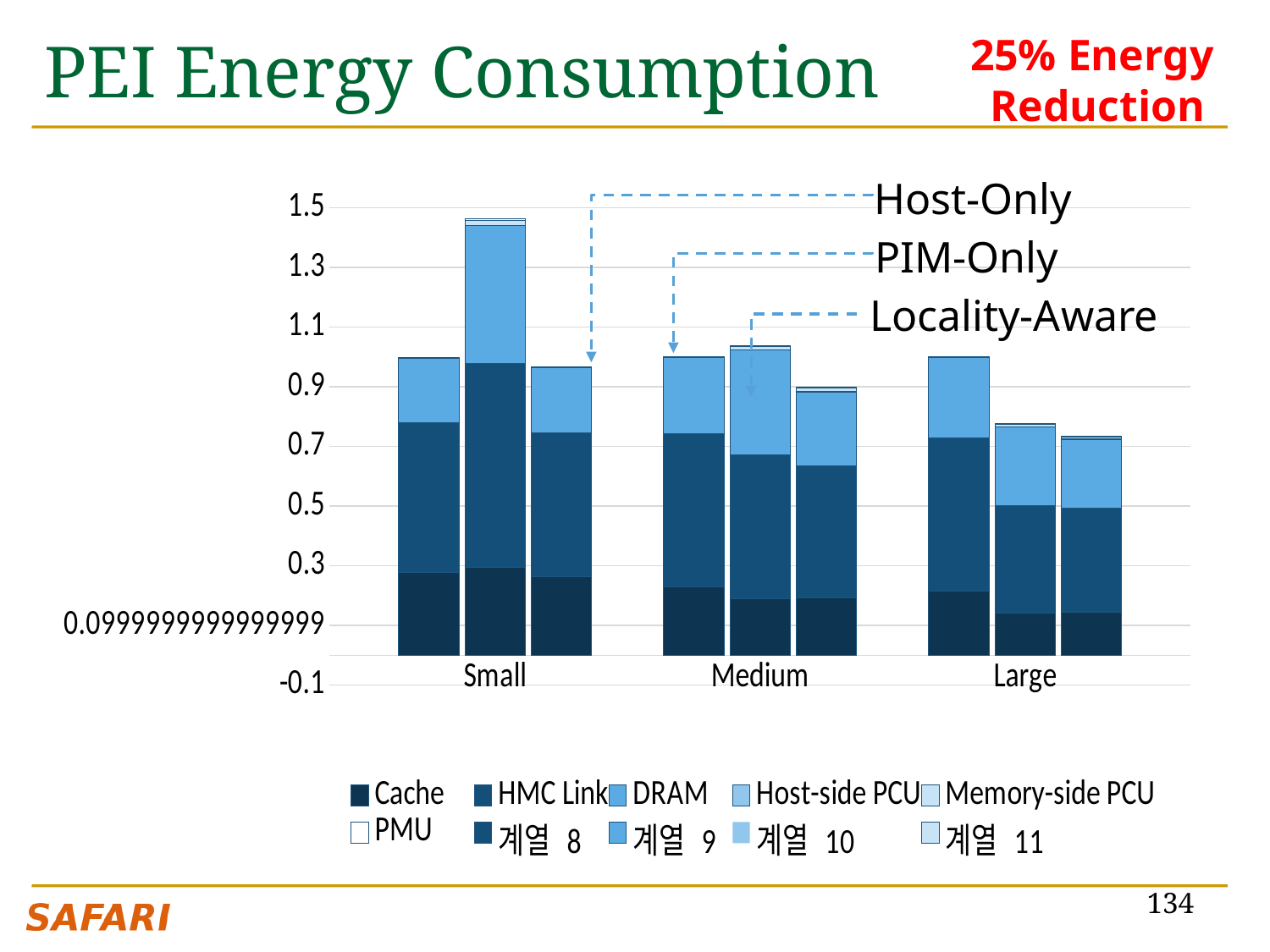
What is the title of the chart on the slide? PEI Energy Consumption Is the total of the PIM-Only bar for Small greater or less than 1.3? greater How many categories are shown on the x axis of the chart? 3 What kind of chart is shown on the slide? stacked bar chart Do the Locality-Aware bar totals rise or fall going from Small to Medium to Large? fall For which category is the PIM-Only bar the tallest? Small Which three configurations are labelled by the dashed arrows pointing at the bars? Host-Only, PIM-Only, Locality-Aware For Small, which bar is taller: Host-Only or PIM-Only? PIM-Only Is the total of the Host-Only bar for Medium greater or less than 0.9? greater Is the total of the PIM-Only bar for Large greater or less than 0.9? less How many series does the chart's legend list? 10